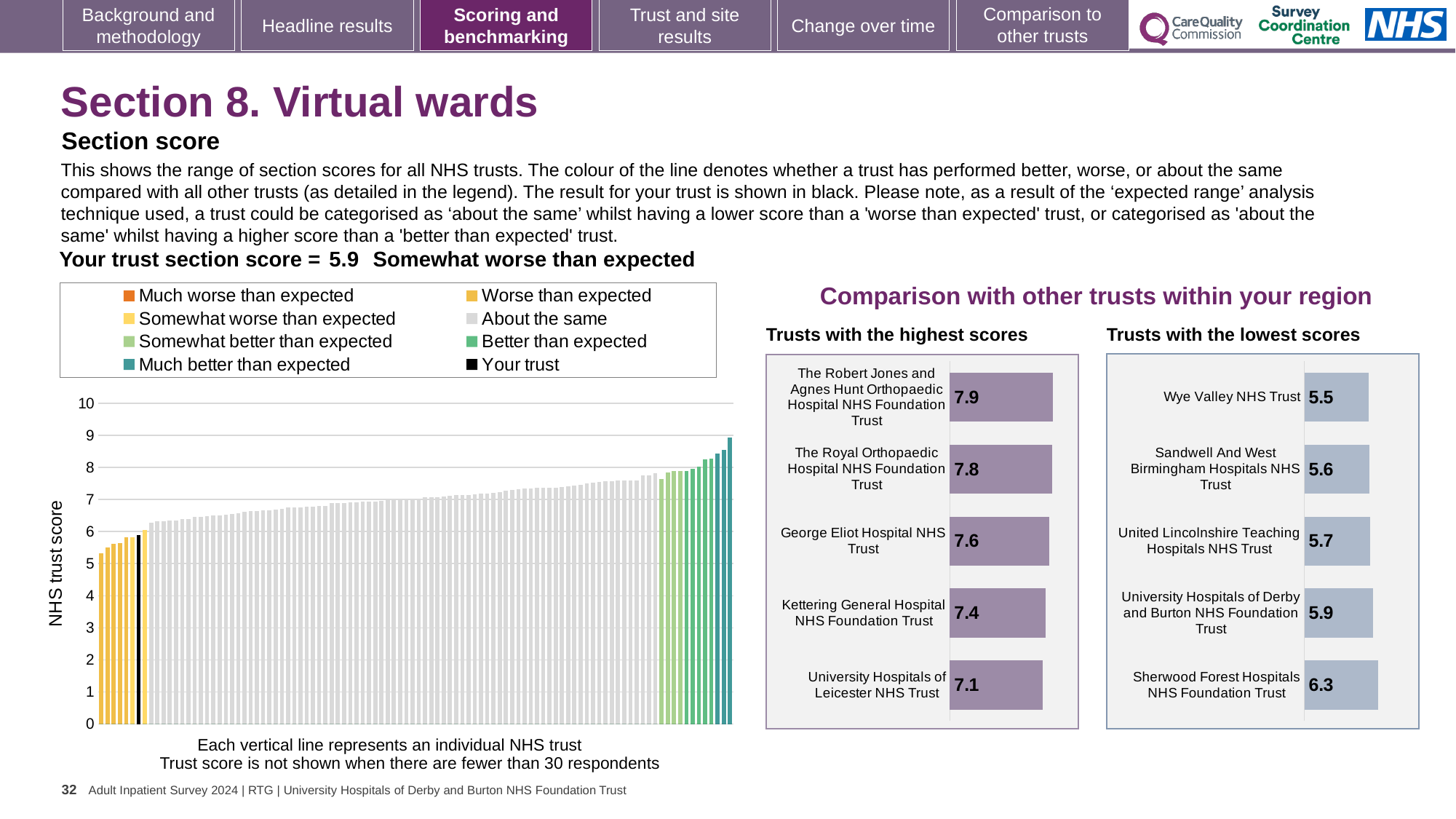
In the 'Trusts with the lowest scores' chart, which has the larger score: Sherwood Forest Hospitals NHS Foundation Trust or United Lincolnshire Teaching Hospitals NHS Trust? Sherwood Forest Hospitals NHS Foundation Trust In the 'Trusts with the lowest scores' chart, which trust has the lowest score? Wye Valley NHS Trust In the 'Trusts with the highest scores' chart, what is the score for George Eliot Hospital NHS Trust? 7.6 In the NHS trust score chart on the left, do the values rise or fall from left to right along the x axis? rise In the 'Trusts with the lowest scores' chart, what is the difference between the scores of Sherwood Forest Hospitals NHS Foundation Trust and Wye Valley NHS Trust? 0.8 How many entries does the legend of the NHS trust score chart on the left list? 8 In the NHS trust score chart on the left, what is the section score for your trust? 5.9 In the 'Trusts with the highest scores' chart, how many trusts are shown? 5 In the 'Trusts with the highest scores' chart, which trust has the highest score? The Robert Jones and Agnes Hunt Orthopaedic Hospital NHS Foundation Trust In the NHS trust score chart on the left, is the value of the tallest bar greater or less than 8? greater In the 'Trusts with the highest scores' chart, what is the difference between the scores of The Royal Orthopaedic Hospital NHS Foundation Trust and University Hospitals of Leicester NHS Trust? 0.7 In the 'Trusts with the lowest scores' chart, what is the score for Sandwell And West Birmingham Hospitals NHS Trust? 5.6